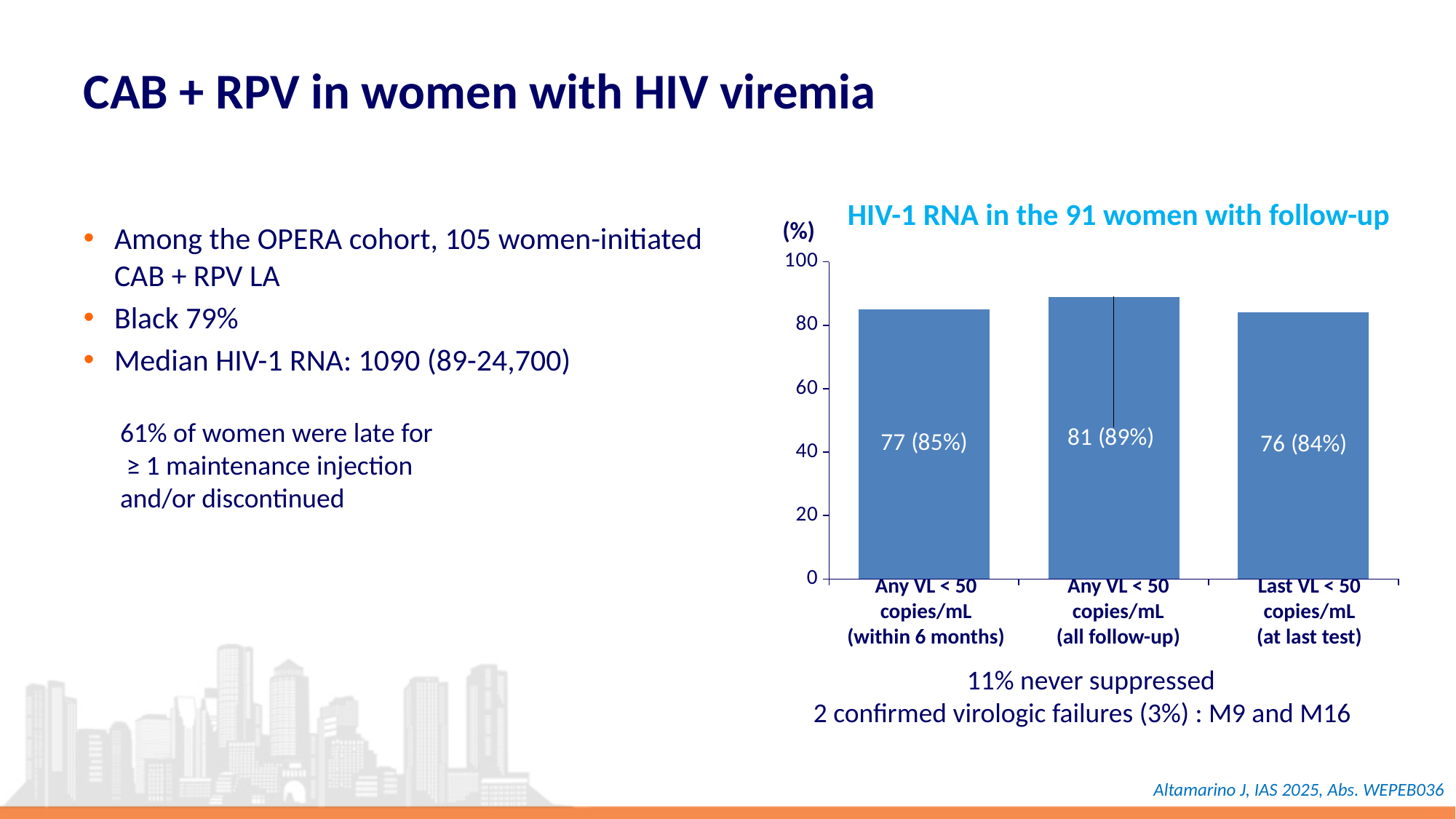
How many bars are shown in the chart? 3 Is the value for 'Any VL < 50 copies/mL (all follow-up)' greater or less than 80? greater What is the data label on the bar for 'Any VL < 50 copies/mL (all follow-up)'? 81 (89%) What is the data label on the bar for 'Any VL < 50 copies/mL (within 6 months)'? 77 (85%) Which is larger: the percentage for 'Any VL < 50 copies/mL (within 6 months)' or for 'Last VL < 50 copies/mL (at last test)'? Any VL < 50 copies/mL (within 6 months) What is the data label on the bar for 'Last VL < 50 copies/mL (at last test)'? 76 (84%) Which category has the lowest percentage in the chart? Last VL < 50 copies/mL (at last test) Which category has the highest percentage in the chart? Any VL < 50 copies/mL (all follow-up) What is the difference in percentage points between 'Any VL < 50 copies/mL (all follow-up)' and 'Last VL < 50 copies/mL (at last test)'? 5 What type of chart is shown on the slide? Bar chart How many more women had any VL < 50 copies/mL over all follow-up than within 6 months? 4 What is the title of the chart? HIV-1 RNA in the 91 women with follow-up